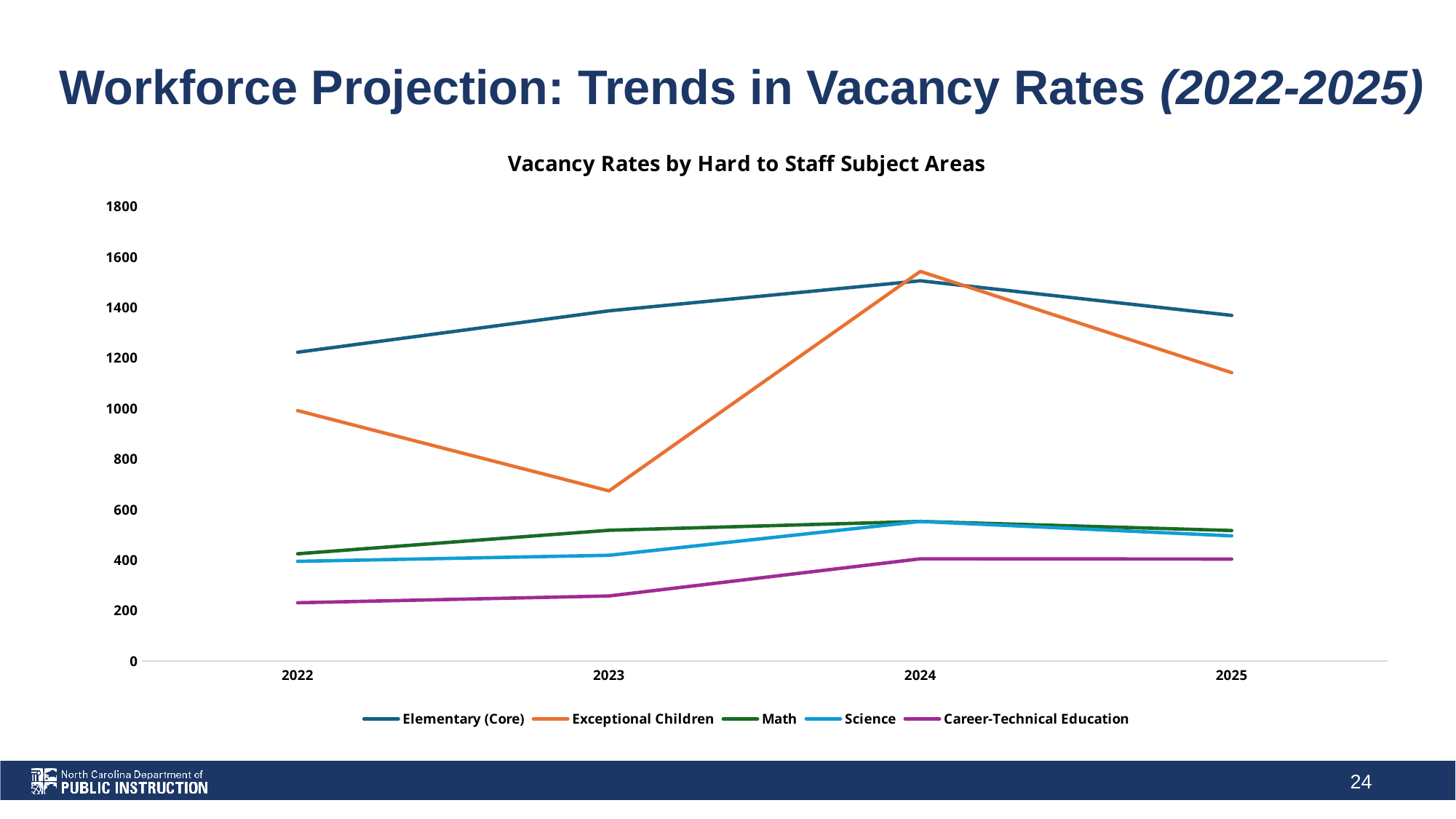
How many series does the legend list? 5 Which series has the lowest value in 2025? Career-Technical Education Is the value for Career-Technical Education in 2022 greater or less than 400? less Which series has the highest value in 2023? Elementary (Core) Is the value for Elementary (Core) in 2022 greater or less than 1000? greater How many years are plotted along the x axis? 4 What is the title of the chart? Vacancy Rates by Hard to Staff Subject Areas Is the value for Exceptional Children in 2023 greater or less than 800? less What kind of chart is shown on the slide? Line chart Does the Career-Technical Education line rise or fall from 2022 to 2024? Rise In 2022, which is larger: Elementary (Core) or Exceptional Children? Elementary (Core) In which year does Exceptional Children reach its lowest value? 2023